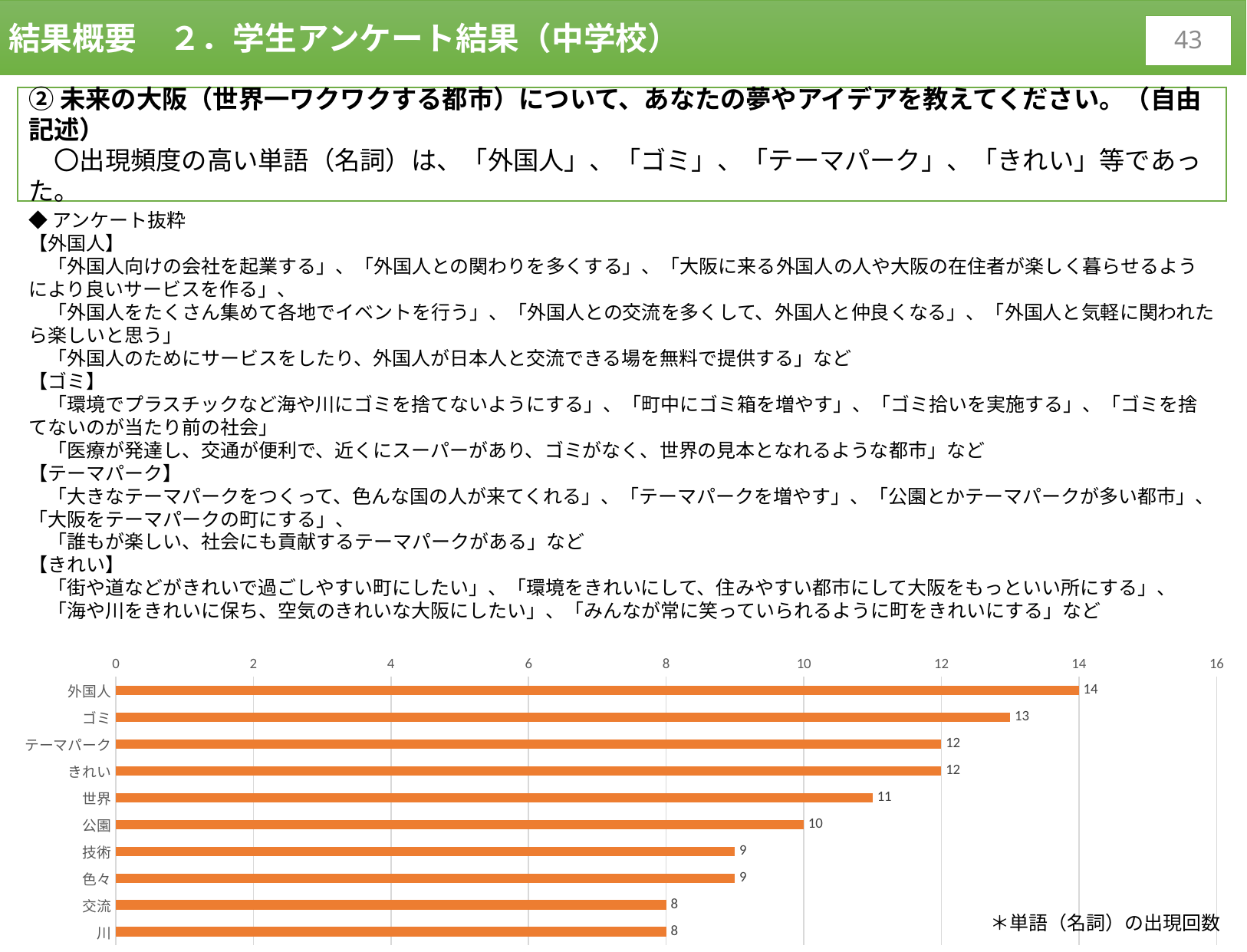
What is the value for 世界 in the bar chart? 11 What is the value for 公園 in the bar chart? 10 What is the value for ゴミ in the bar chart? 13 Which category has the highest value in the bar chart? 外国人 What is the value for 外国人 in the bar chart? 14 What kind of chart is shown on the slide? bar chart Do the values in the bar chart increase or decrease from the top category to the bottom category? decrease Which is larger, the value for テーマパーク or the value for 技術? テーマパーク What colour are the bars in the chart? orange How many categories are shown in the bar chart? 10 What is the difference between the values for ゴミ and 公園? 3 What is the difference between the values for 外国人 and 川? 6